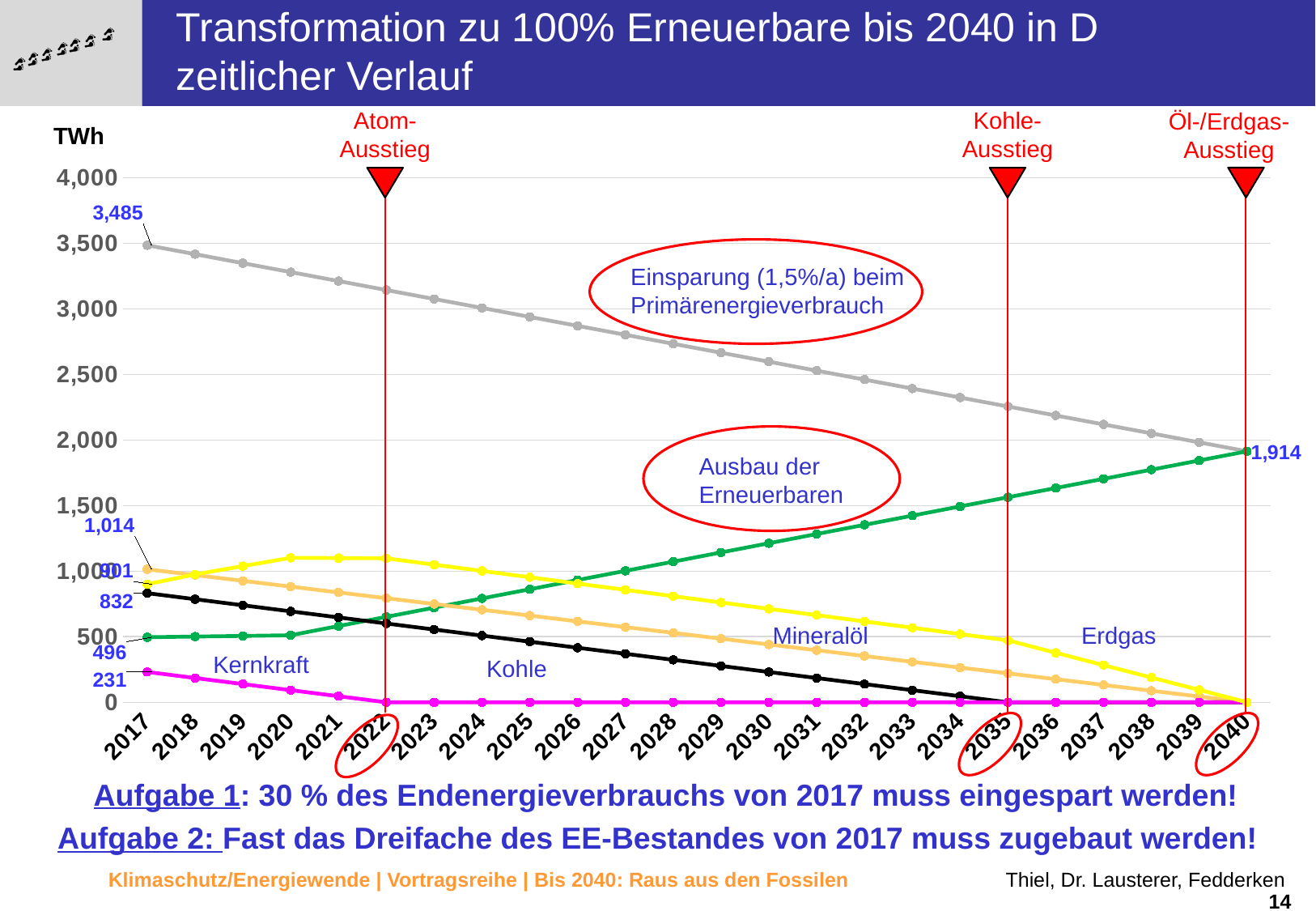
What is the value of the Mineralöl line in 2017? 1,014 In which year is the Atom-Ausstieg marked on the chart? 2022 What kind of chart is shown on the slide? line chart How many years are shown on the x axis? 24 What is the value of the Kernkraft line in 2017? 231 Is the value of the Kohle line in 2030 greater or less than 500? less What is the value of the grey Primärenergieverbrauch line in 2017? 3,485 Does the grey Primärenergieverbrauch line rise or fall from 2017 to 2040? fall Does the green Erneuerbare line rise or fall from 2017 to 2040? rise What value do the grey and green lines reach in 2040? 1,914 By how much does the grey Primärenergieverbrauch line fall from 2017 (3,485) to 2040 (1,914)? 1,571 What is the value of the Kohle line in 2017? 832